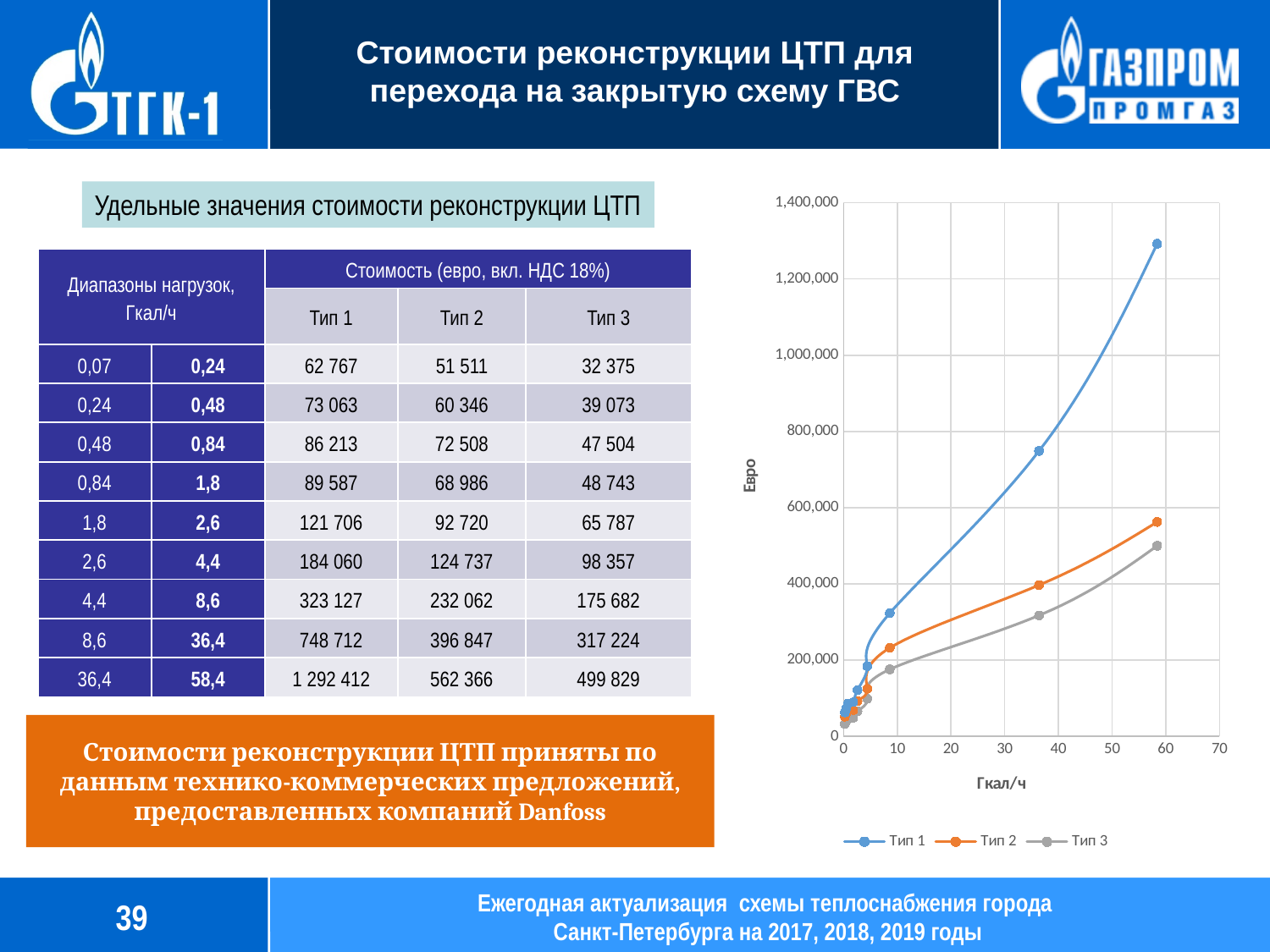
How many series does the chart legend list? 3 What is the label of the chart's horizontal axis? Гкал/ч Do the values of Тип 1 rise or fall as Гкал/ч increases along the x axis? rise What kind of chart is shown on the right of the slide? line chart Is the value of Тип 3 at about 36 Гкал/ч greater or less than 400,000? less At the rightmost point (about 58 Гкал/ч), which is larger: Тип 2 or Тип 3? Тип 2 Is the value of Тип 1 at about 36 Гкал/ч greater or less than 800,000? less Which series reaches the highest value on the chart? Тип 1 What is the label of the chart's vertical axis? Евро Is the last (rightmost) value of Тип 1 greater or less than 1,200,000? greater Which series has the lowest values across the chart? Тип 3